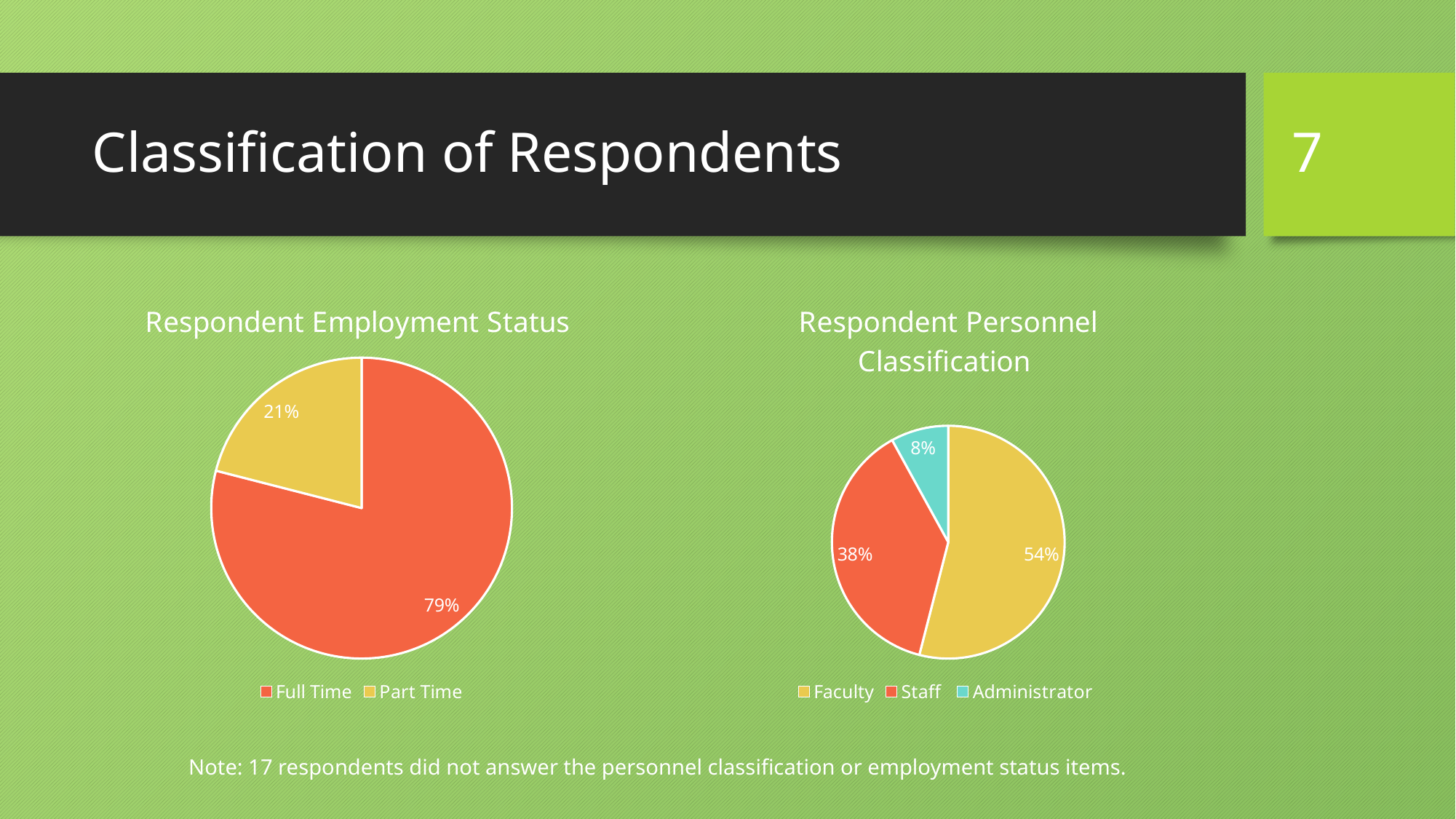
In the Respondent Personnel Classification chart, which category has the largest share? Faculty In the Respondent Personnel Classification chart, which category has the smallest share? Administrator In the Respondent Personnel Classification chart, what share of respondents are Faculty? 54% In the Respondent Employment Status chart, what share of respondents are Part Time? 21% In the Respondent Personnel Classification chart, which is larger, Staff or Administrator? Staff In the Respondent Personnel Classification chart, what share of respondents are Administrator? 8% In the Respondent Employment Status chart, what is the difference in percentage points between Full Time and Part Time? 58 How many categories does the Respondent Personnel Classification chart show? 3 What kind of chart is the Respondent Employment Status chart? Pie chart In the Respondent Personnel Classification chart, what is the difference in percentage points between Faculty and Staff? 16